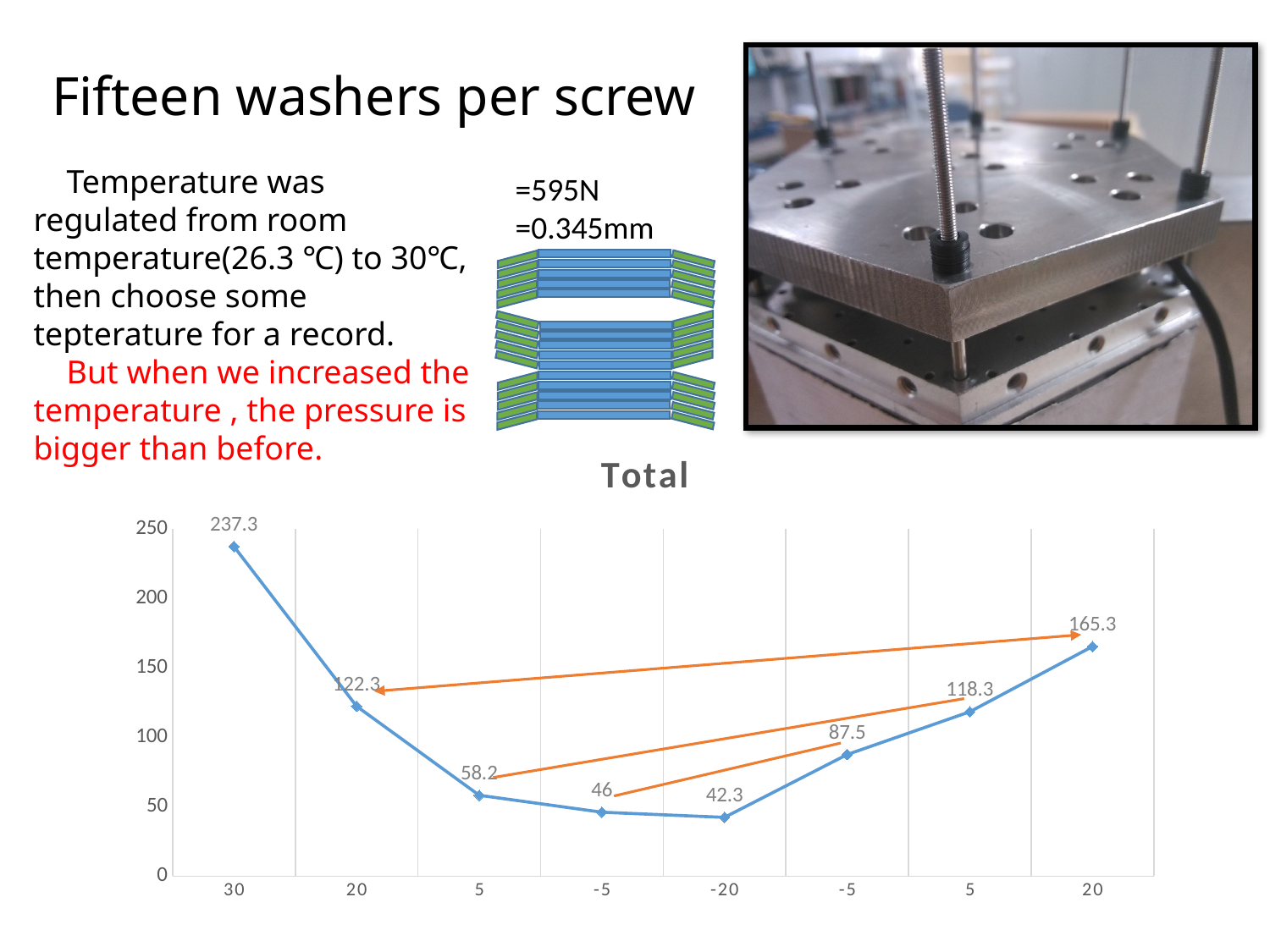
Which is larger: the value at the first x-axis label 5 (58.2) or the value at the second x-axis label 5 (118.3)? 118.3 (second label 5) What type of chart is shown under the title "Total"? line chart How many data points are plotted on the line in the "Total" chart? 8 Do the values fall or rise from the first data point (30) to the fifth data point (-20)? fall What is the difference between the first data point (237.3) and the second data point (122.3)? 115 What is the value of the data point at the x-axis label -20? 42.3 What is the value of the first data point, at x-axis label 30? 237.3 Which data point has the highest value in the "Total" chart? 237.3 (at x-axis label 30) What is the value of the last data point, at the rightmost x-axis label 20? 165.3 Which data point has the lowest value in the "Total" chart? 42.3 (at x-axis label -20) What is the title of the chart? Total What is the value of the second data point, at the first x-axis label 20? 122.3